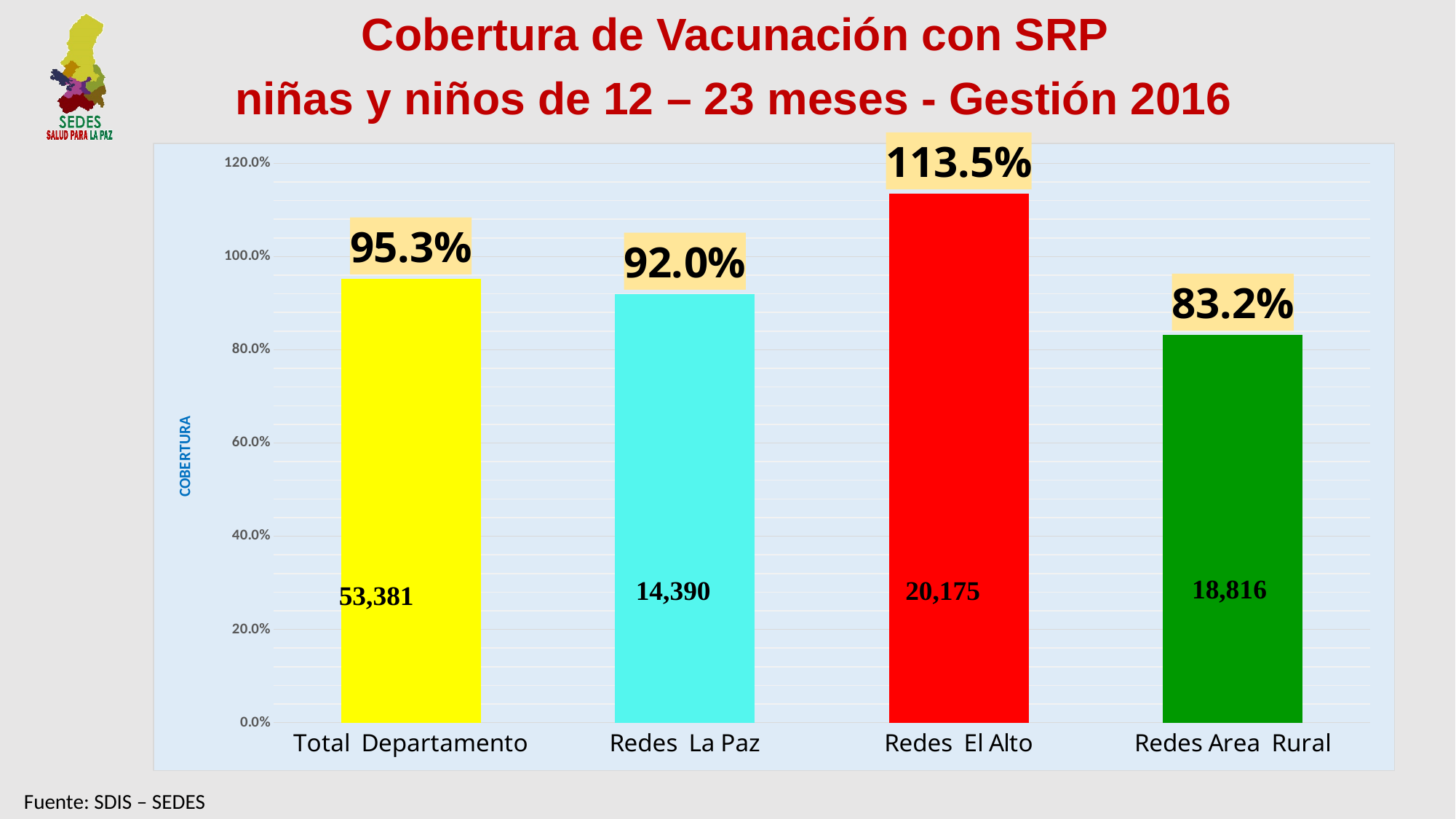
What is the coverage percentage for Redes El Alto? 113.5% What number is printed inside the bar for Redes Area Rural? 18,816 What kind of chart is shown on the slide? bar chart What is the coverage percentage for Total Departamento? 95.3% What number is printed inside the bar for Redes La Paz? 14,390 What is the difference in coverage percentage between Redes El Alto and Redes Area Rural? 30.3% Which has a higher coverage percentage, Total Departamento or Redes La Paz? Total Departamento Is the coverage for Redes Area Rural greater or less than 100.0%? less What colour is the bar for Redes El Alto? red Which category has the highest coverage percentage? Redes El Alto Which category has the lowest coverage percentage? Redes Area Rural How many categories are shown on the x axis? 4